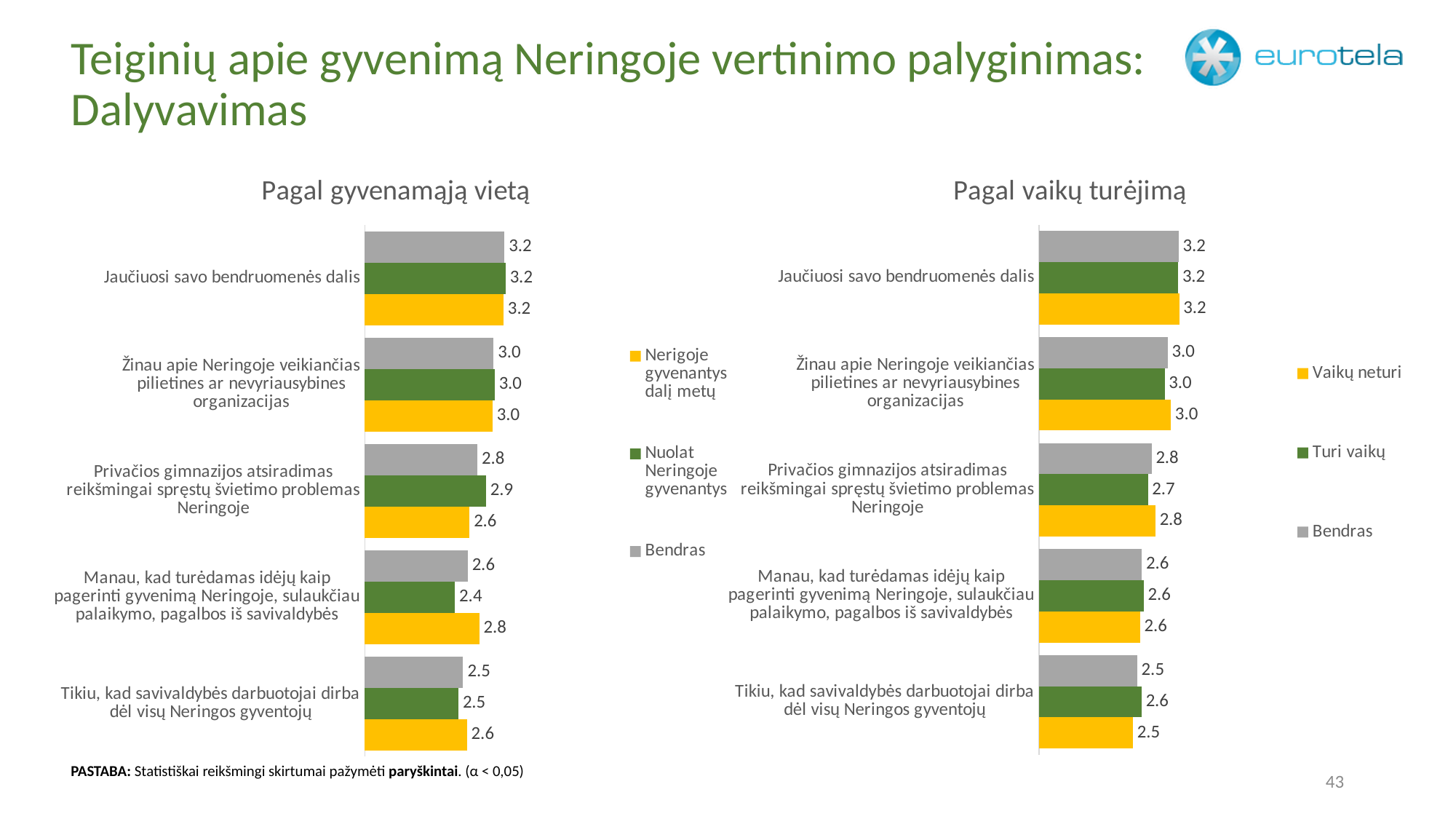
In the 'Pagal gyvenamąją vietą' chart, for 'Privačios gimnazijos atsiradimas reikšmingai spręstų švietimo problemas Neringoje', which is larger: 'Nuolat Neringoje gyvenantys' or 'Nerigoje gyvenantys dalį metų'? Nuolat Neringoje gyvenantys How many statements (categories) are shown in the 'Pagal vaikų turėjimą' chart? 5 In the 'Pagal vaikų turėjimą' chart, which statement has the lowest 'Bendras' value? Tikiu, kad savivaldybės darbuotojai dirba dėl visų Neringos gyventojų How many series does the legend of the 'Pagal gyvenamąją vietą' chart list? 3 In the 'Pagal gyvenamąją vietą' chart, which statement has the highest 'Bendras' value? Jaučiuosi savo bendruomenės dalis In the 'Pagal vaikų turėjimą' chart, what is the value for 'Vaikų neturi' on the statement 'Tikiu, kad savivaldybės darbuotojai dirba dėl visų Neringos gyventojų'? 2.5 In the 'Pagal vaikų turėjimą' chart, what is the value for 'Turi vaikų' on the statement 'Privačios gimnazijos atsiradimas reikšmingai spręstų švietimo problemas Neringoje'? 2.7 In the 'Pagal gyvenamąją vietą' chart, what is the value for 'Nuolat Neringoje gyvenantys' on the statement 'Manau, kad turėdamas idėjų kaip pagerinti gyvenimą Neringoje, sulaukčiau palaikymo, pagalbos iš savivaldybės'? 2.4 In the 'Pagal vaikų turėjimą' chart, for 'Tikiu, kad savivaldybės darbuotojai dirba dėl visų Neringos gyventojų', which is larger: 'Turi vaikų' or 'Vaikų neturi'? Turi vaikų In the 'Pagal gyvenamąją vietą' chart, what is the difference between the 'Nerigoje gyvenantys dalį metų' and 'Nuolat Neringoje gyvenantys' values for 'Manau, kad turėdamas idėjų kaip pagerinti gyvenimą Neringoje, sulaukčiau palaikymo, pagalbos iš savivaldybės'? 0.4 What type of chart is the 'Pagal vaikų turėjimą' chart? Bar chart In the 'Pagal gyvenamąją vietą' chart, what is the value for 'Nerigoje gyvenantys dalį metų' on the statement 'Privačios gimnazijos atsiradimas reikšmingai spręstų švietimo problemas Neringoje'? 2.6